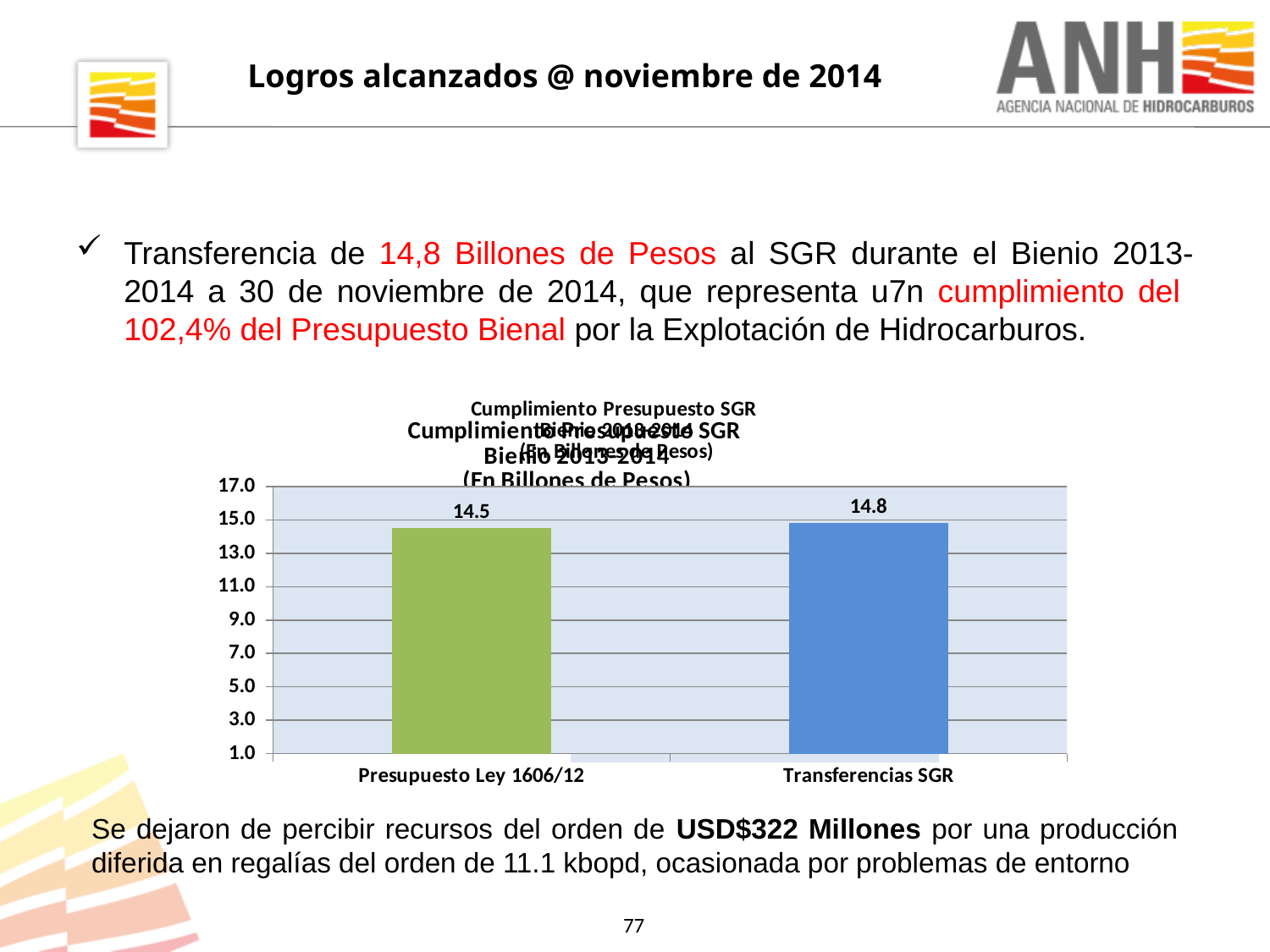
Which category has the higher value? Transferencias SGR What is the difference between the Transferencias SGR value and the Presupuesto Ley 1606/12 value? 0.3 Is the value for Transferencias SGR larger or smaller than the value for Presupuesto Ley 1606/12? larger Is the value for Presupuesto Ley 1606/12 greater or less than 13.0? greater What unit does the chart title say the values are in? Billones de Pesos What is the value for Presupuesto Ley 1606/12? 14.5 What kind of chart is shown on the slide? bar chart What colour is the bar for Transferencias SGR? blue Is the value for Transferencias SGR greater or less than 15.0? less Which category has the lower value? Presupuesto Ley 1606/12 How many categories are shown on the chart? 2 What is the value for Transferencias SGR? 14.8